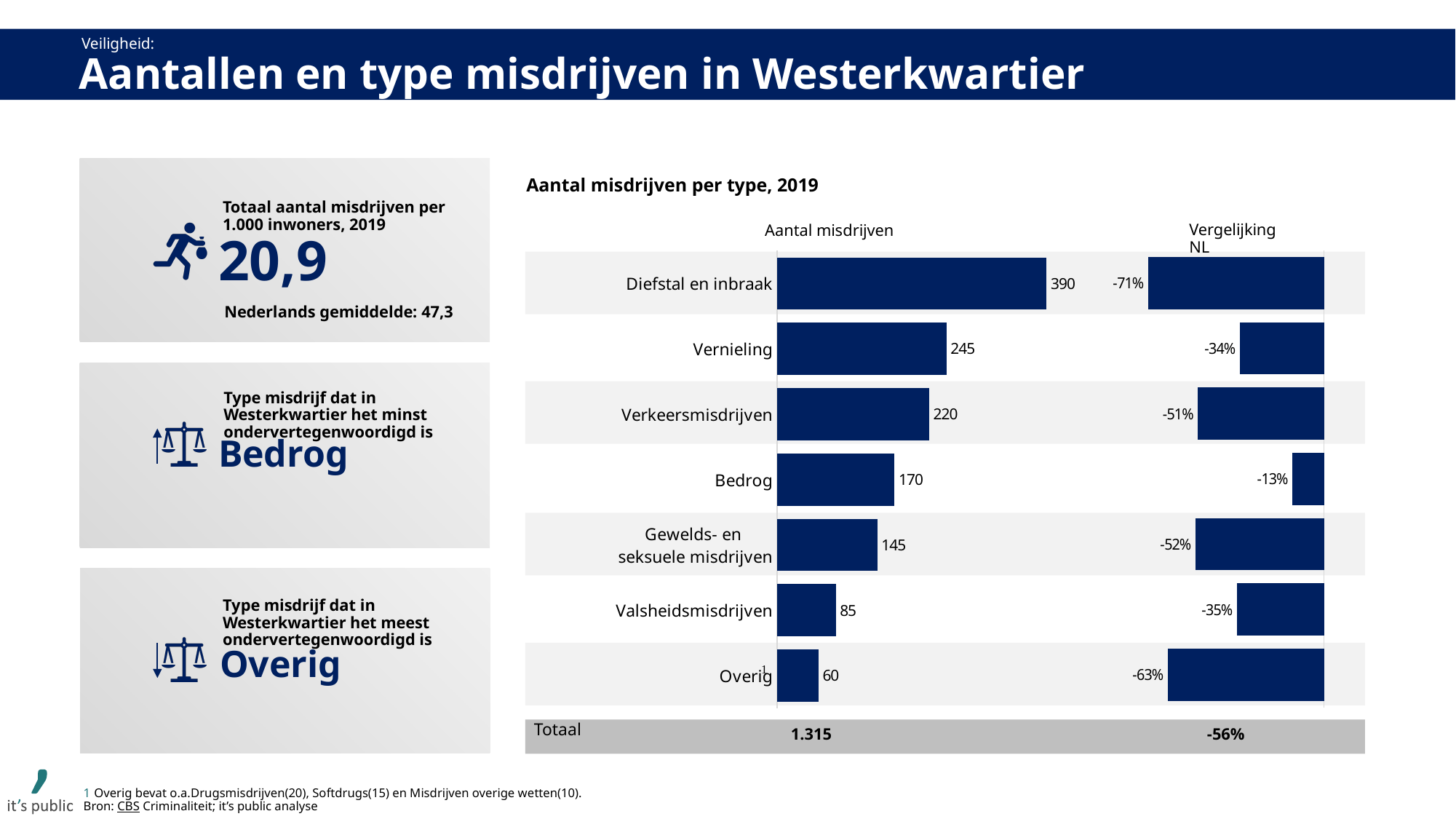
In the chart 'Aantal misdrijven per type, 2019', what is the Totaal value for Aantal misdrijven? 1.315 In the chart 'Aantal misdrijven per type, 2019', what is the Aantal misdrijven value for Diefstal en inbraak? 390 In the chart 'Aantal misdrijven per type, 2019', what is the Vergelijking NL value for Overig? -63% In the chart 'Aantal misdrijven per type, 2019', what is the Vergelijking NL value for Bedrog? -13% What kind of chart is 'Aantal misdrijven per type, 2019'? Bar chart In the chart 'Aantal misdrijven per type, 2019', what is the difference in Aantal misdrijven between Vernieling and Verkeersmisdrijven? 25 How many data columns (series) does the chart 'Aantal misdrijven per type, 2019' show? 2 In the chart 'Aantal misdrijven per type, 2019', what is the Aantal misdrijven value for Valsheidsmisdrijven? 85 In the chart 'Aantal misdrijven per type, 2019', which crime type has the highest Aantal misdrijven? Diefstal en inbraak In the chart 'Aantal misdrijven per type, 2019', which has a higher Aantal misdrijven: Bedrog or Gewelds- en seksuele misdrijven? Bedrog In the chart 'Aantal misdrijven per type, 2019', which crime type has the lowest Aantal misdrijven? Overig How many crime types are shown in the chart 'Aantal misdrijven per type, 2019' (excluding the Totaal row)? 7